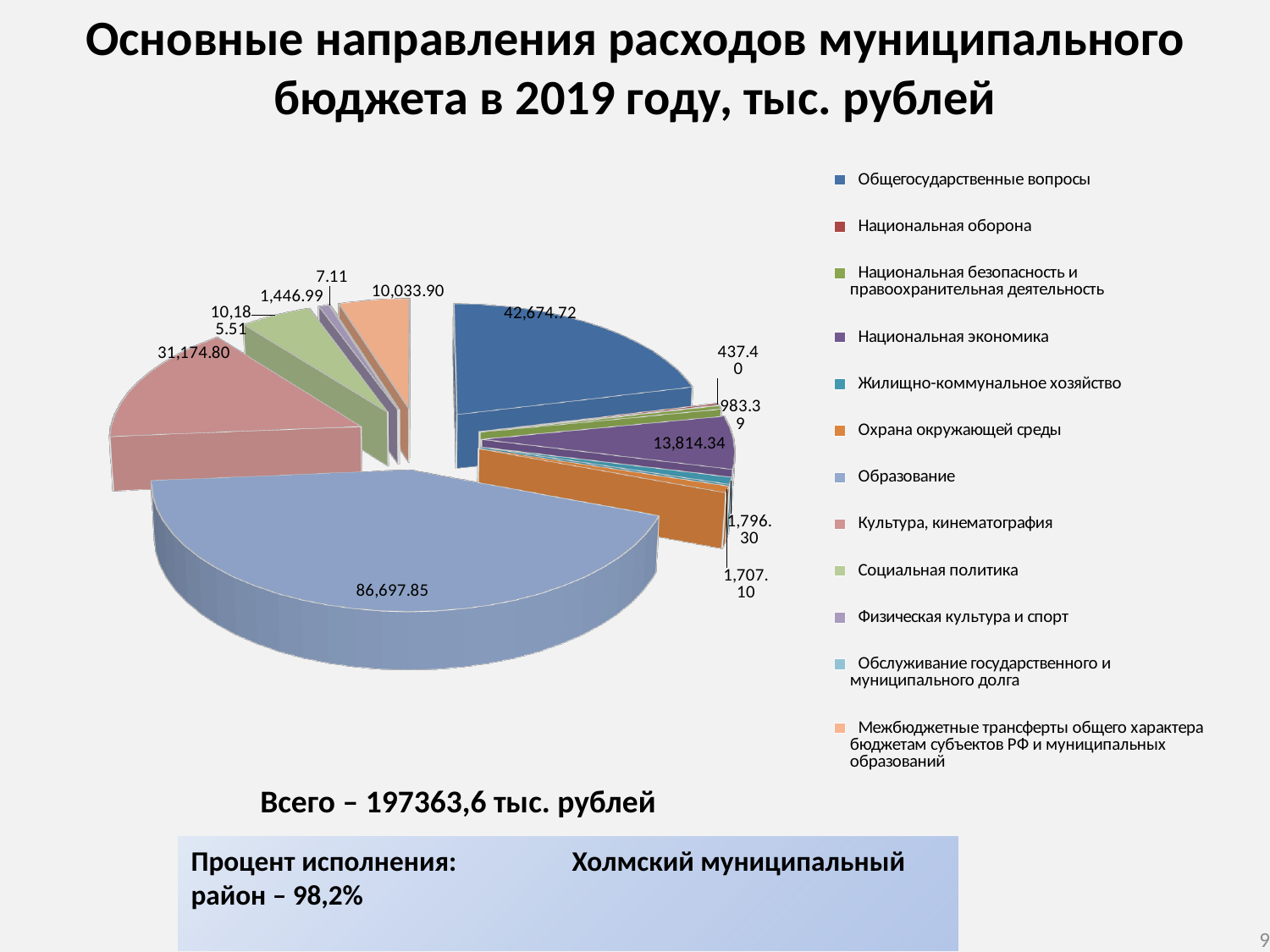
What is the difference between the values for Образование and Общегосударственные вопросы? 44,023.13 What kind of chart is shown on the slide? pie chart What is the value shown for Образование? 86,697.85 What total amount is stated below the chart? 197363,6 тыс. рублей What is the value shown for Культура, кинематография? 31,174.80 What is the value shown for Национальная экономика? 13,814.34 Which category has the largest slice of the pie chart? Образование What is the value shown for Межбюджетные трансферты общего характера бюджетам субъектов РФ и муниципальных образований? 10,033.90 How many categories does the legend of the pie chart list? 12 Which is larger: the value for Культура, кинематография or the value for Национальная экономика? Культура, кинематография Which category has the smallest slice of the pie chart? Обслуживание государственного и муниципального долга What is the value shown for Общегосударственные вопросы? 42,674.72